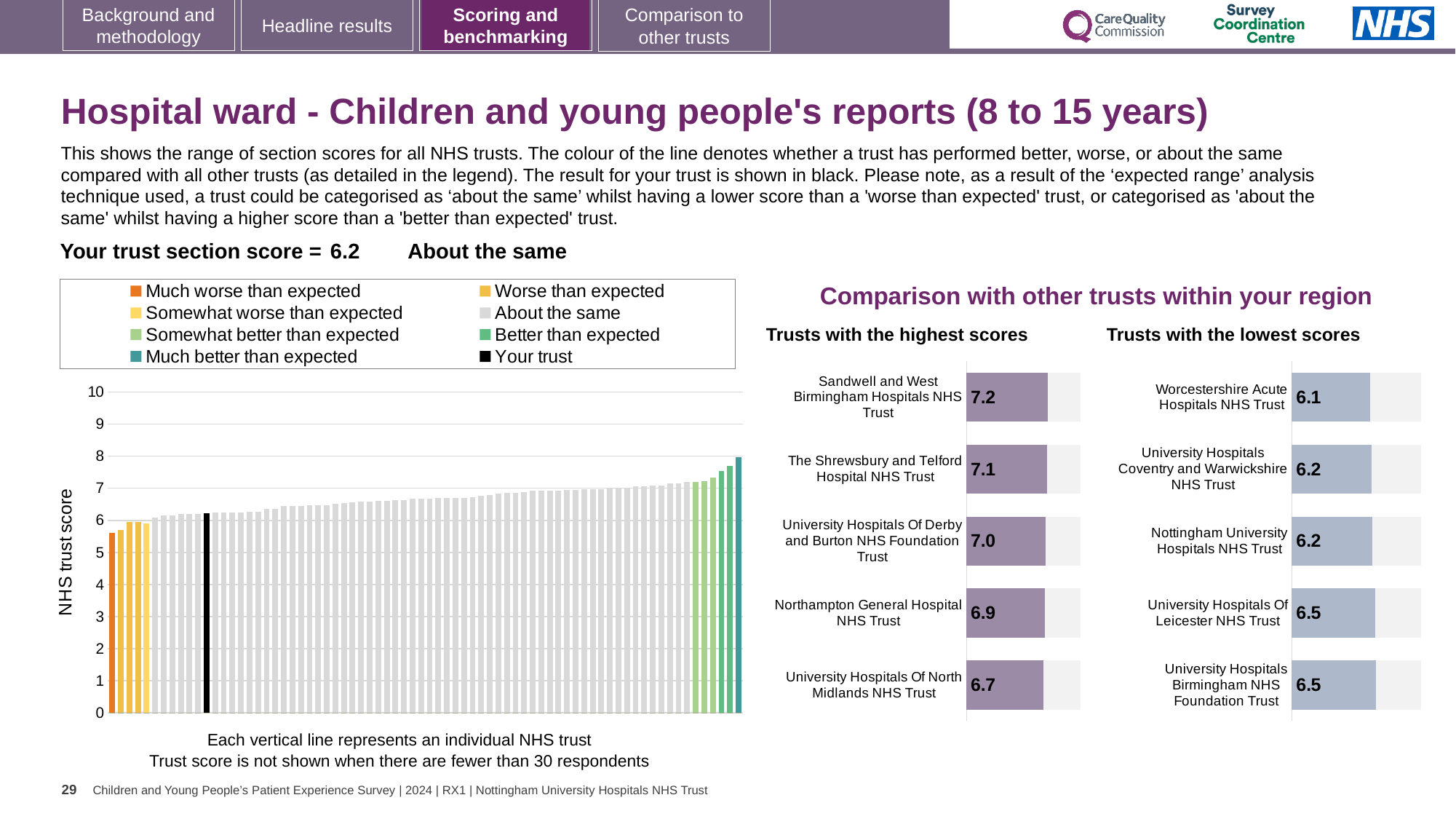
In the 'Trusts with the lowest scores' chart, what is the score for University Hospitals Of Leicester NHS Trust? 6.5 In the large chart on the left showing all NHS trusts, do the bar values rise or fall from left to right? rise Which is larger: the score for Sandwell and West Birmingham Hospitals NHS Trust in the highest scores chart, or the score for Worcestershire Acute Hospitals NHS Trust in the lowest scores chart? Sandwell and West Birmingham Hospitals NHS Trust In the 'Trusts with the lowest scores' chart, what is the difference between the scores of University Hospitals Of Leicester NHS Trust and Worcestershire Acute Hospitals NHS Trust? 0.4 In the large chart on the left showing all NHS trusts, is the value of the tallest bar greater or less than 7? greater In the large chart on the left showing all NHS trusts, what is the section score for your trust (the black bar)? 6.2 How many entries does the legend above the large chart on the left list? 8 In the 'Trusts with the highest scores' chart, which trust has the lowest score? University Hospitals Of North Midlands NHS Trust In the 'Trusts with the highest scores' chart, what is the difference between the scores of Sandwell and West Birmingham Hospitals NHS Trust and University Hospitals Of North Midlands NHS Trust? 0.5 In the 'Trusts with the highest scores' chart, how many trusts are shown? 5 In the 'Trusts with the lowest scores' chart, what is the score for Worcestershire Acute Hospitals NHS Trust? 6.1 In the 'Trusts with the highest scores' chart, what is the score for Sandwell and West Birmingham Hospitals NHS Trust? 7.2